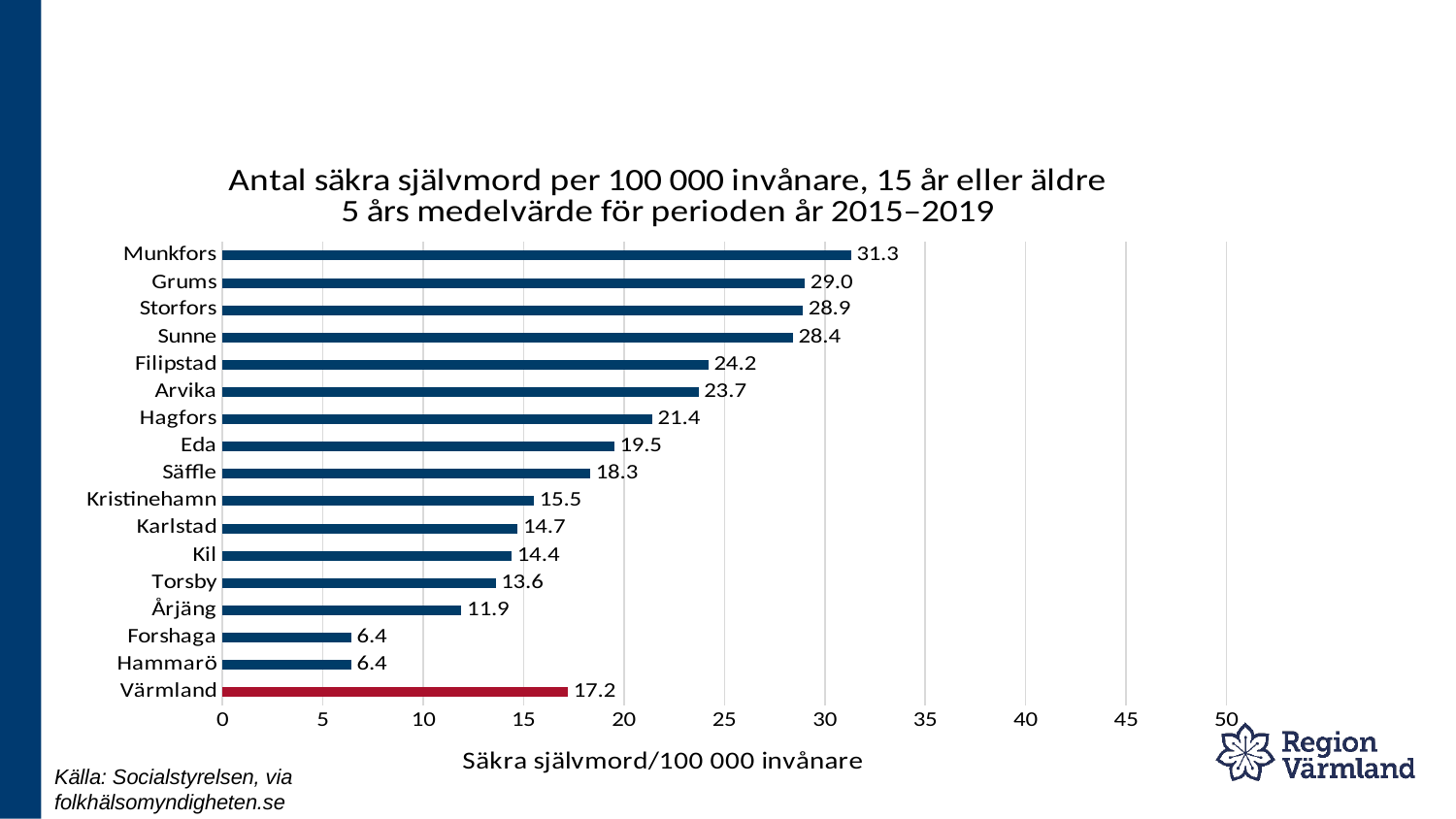
What is the value for Kristinehamn? 15.5 What is the value for Värmland? 17.2 What is the difference between the values for Munkfors and Värmland? 14.1 What is the value for Munkfors? 31.3 What is the x-axis title of the chart? Säkra självmord/100 000 invånare Which category has the highest value? Munkfors Is the value for Hagfors greater or less than 20? greater Which is larger, the value for Filipstad or the value for Eda? Filipstad What is the difference between the values for Grums and Storfors? 0.1 Which bar is shown in a different colour (red) from the others? Värmland What kind of chart is shown on the slide? Bar chart How many bars are shown in the chart? 17